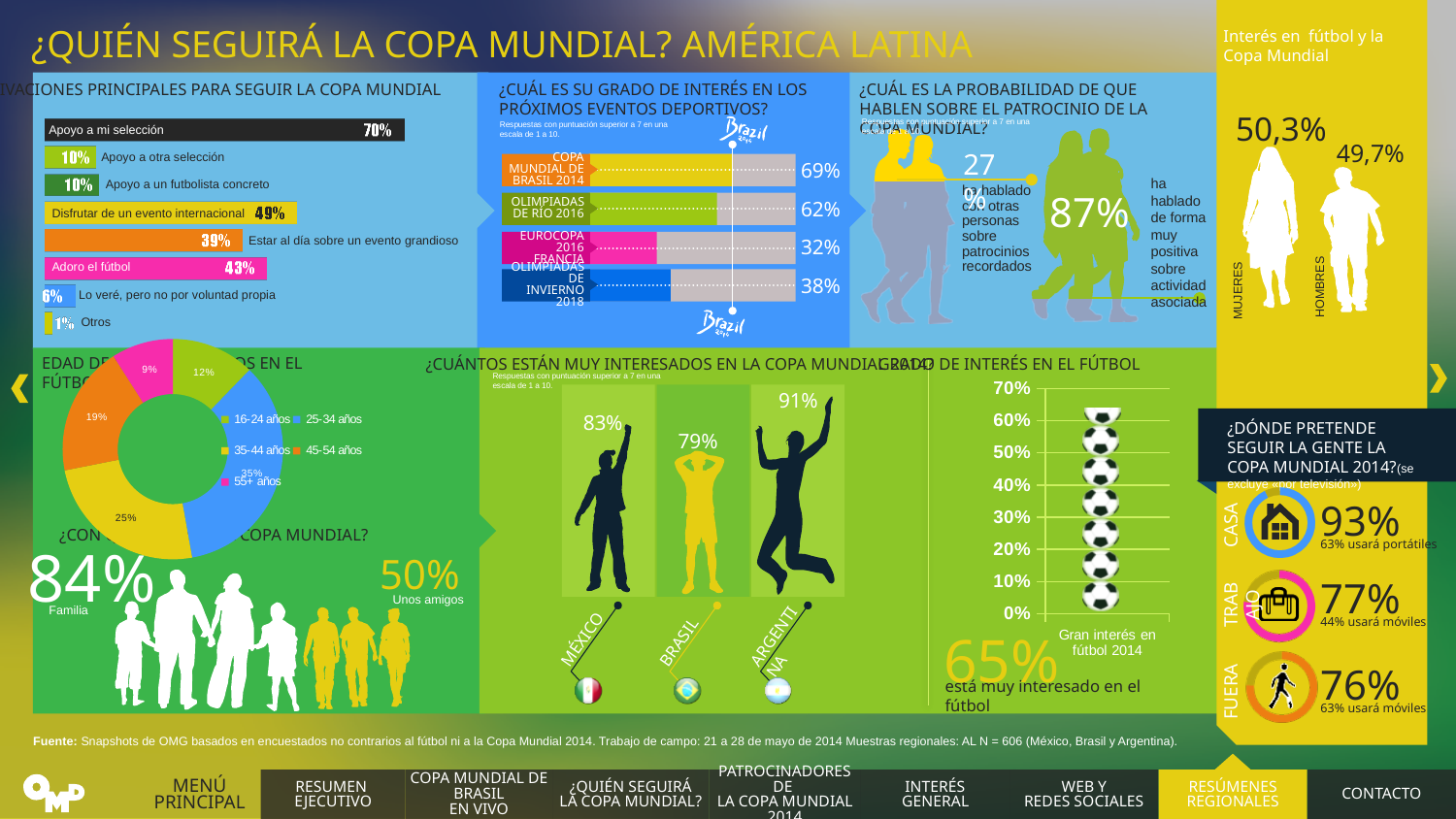
In the '¿Cuál es su grado de interés en los próximos eventos deportivos?' chart, which is larger: 'Eurocopa 2016 Francia' or 'Olimpiadas de Invierno 2018'? Olimpiadas de Invierno 2018 In the 'Motivaciones principales para seguir la Copa Mundial' chart, what percentage is shown for 'Apoyo a mi selección'? 70% In the 'Motivaciones principales para seguir la Copa Mundial' chart, which motivation has the lowest percentage? Otros In the '¿Cuál es su grado de interés en los próximos eventos deportivos?' chart, what is the value for 'Olimpiadas de Río 2016'? 62% In the 'Motivaciones principales para seguir la Copa Mundial' chart, what is the difference between 'Disfrutar de un evento internacional' and 'Estar al día sobre un evento grandioso'? 10% In the '¿Cuál es su grado de interés en los próximos eventos deportivos?' chart, which event has the highest interest? Copa Mundial de Brasil 2014 In the '¿Cuántos están muy interesados en la Copa Mundial?' chart, what is the difference between Argentina and México? 8% How many age groups does the legend of the 'Edad de los interesados en el fútbol' donut chart list? 5 In the '¿Dónde pretende seguir la gente la Copa Mundial 2014?' section, what percentage is shown for 'Trabajo'? 77% In the '¿Cuántos están muy interesados en la Copa Mundial?' chart, which country has the highest percentage? Argentina What kind of chart is used for 'Edad de los interesados en el fútbol'? Pie (donut) chart In the '¿Cuántos están muy interesados en la Copa Mundial?' chart, what is the value for Brasil? 79%